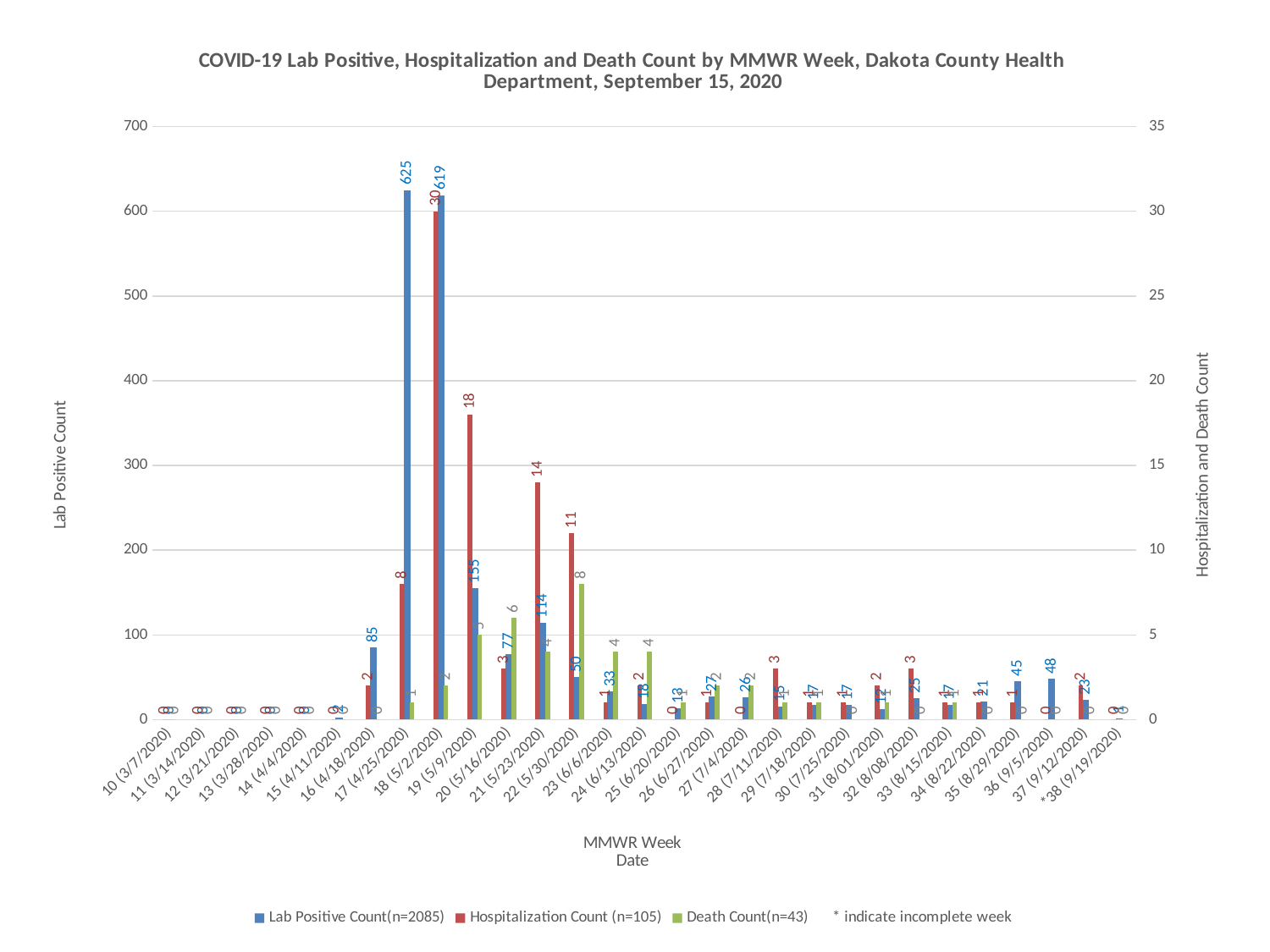
Which MMWR week has the highest Death Count? 22 (5/30/2020) What is the Hospitalization Count for MMWR week 19 (5/9/2020)? 18 Which is larger, the Hospitalization Count in week 19 (5/9/2020) or in week 21 (5/23/2020)? week 19 (5/9/2020) Is the Lab Positive Count for week 19 (5/9/2020) greater or less than 100? greater Which MMWR week has the highest Lab Positive Count? 17 (4/25/2020) What is the Lab Positive Count for MMWR week 16 (4/18/2020)? 85 Does the Lab Positive Count rise or fall from week 18 (5/2/2020) to week 22 (5/30/2020)? fall What kind of chart is shown on the slide? bar chart What is the difference between the Lab Positive Count in week 17 (4/25/2020) and week 18 (5/2/2020)? 6 What is the Lab Positive Count for MMWR week 17 (4/25/2020)? 625 How many series does the legend list? 3 Which MMWR week has the highest Hospitalization Count? 18 (5/2/2020)